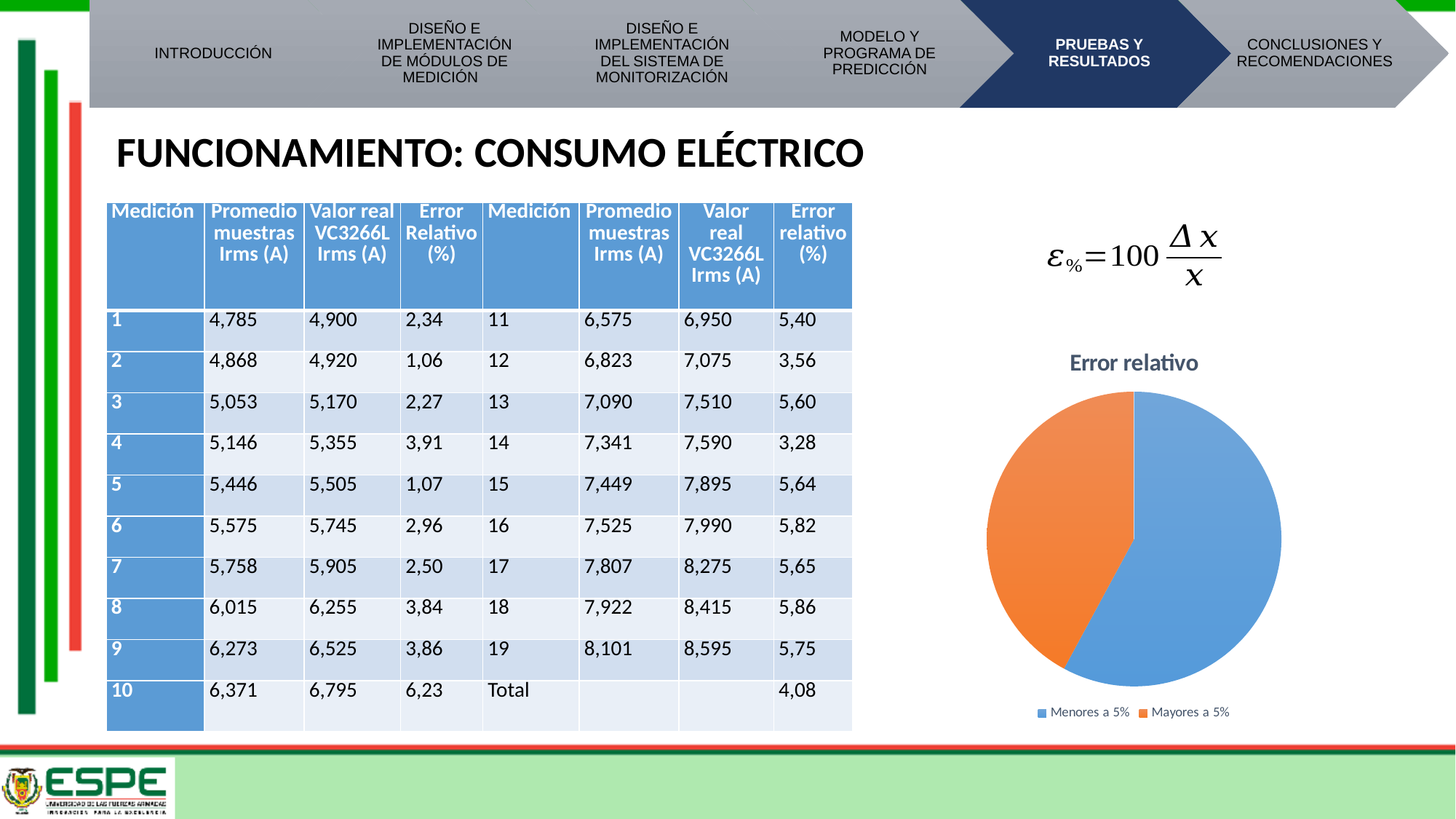
Which category has the smallest slice in the pie chart? Mayores a 5% What kind of chart is shown on the right side of the slide? pie chart What colour is the "Mayores a 5%" slice in the pie chart? orange How many slices does the pie chart have? 2 What is the title of the pie chart? Error relativo Which category has the largest slice in the pie chart? Menores a 5% Which slice of the pie chart is larger, "Menores a 5%" or "Mayores a 5%"? Menores a 5% How many entries does the legend of the pie chart list? 2